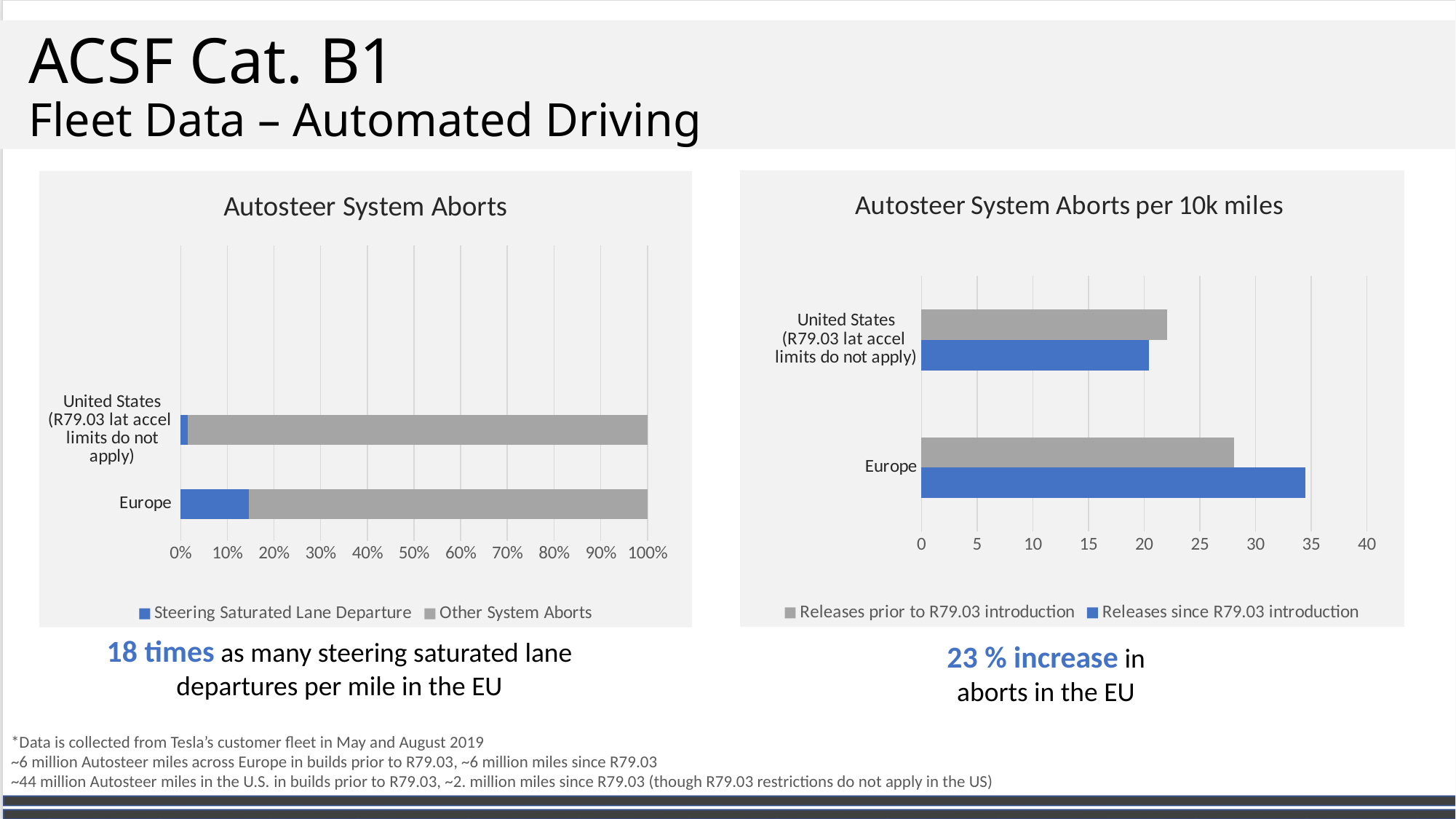
In the 'Autosteer System Aborts per 10k miles' chart, is the value for United States under 'Releases prior to R79.03 introduction' greater or less than 25? less In the 'Autosteer System Aborts per 10k miles' chart, for Europe, which series has the larger value: 'Releases prior to R79.03 introduction' or 'Releases since R79.03 introduction'? Releases since R79.03 introduction In the 'Autosteer System Aborts' chart, which category has the larger 'Steering Saturated Lane Departure' share, United States or Europe? Europe In the 'Autosteer System Aborts' chart, is the 'Steering Saturated Lane Departure' share for Europe greater or less than 10%? greater In the 'Autosteer System Aborts per 10k miles' chart, which series is shown in blue? Releases since R79.03 introduction What kind of chart is the 'Autosteer System Aborts per 10k miles' chart on the right? bar chart What kind of chart is the 'Autosteer System Aborts' chart on the left? bar chart In the 'Autosteer System Aborts per 10k miles' chart, is the value for Europe under 'Releases prior to R79.03 introduction' greater or less than 25? greater In the 'Autosteer System Aborts' chart, how many series does the legend list? 2 In the 'Autosteer System Aborts per 10k miles' chart, how many categories are shown on the vertical axis? 2 In the 'Autosteer System Aborts per 10k miles' chart, which category has the higher value for 'Releases since R79.03 introduction', United States or Europe? Europe